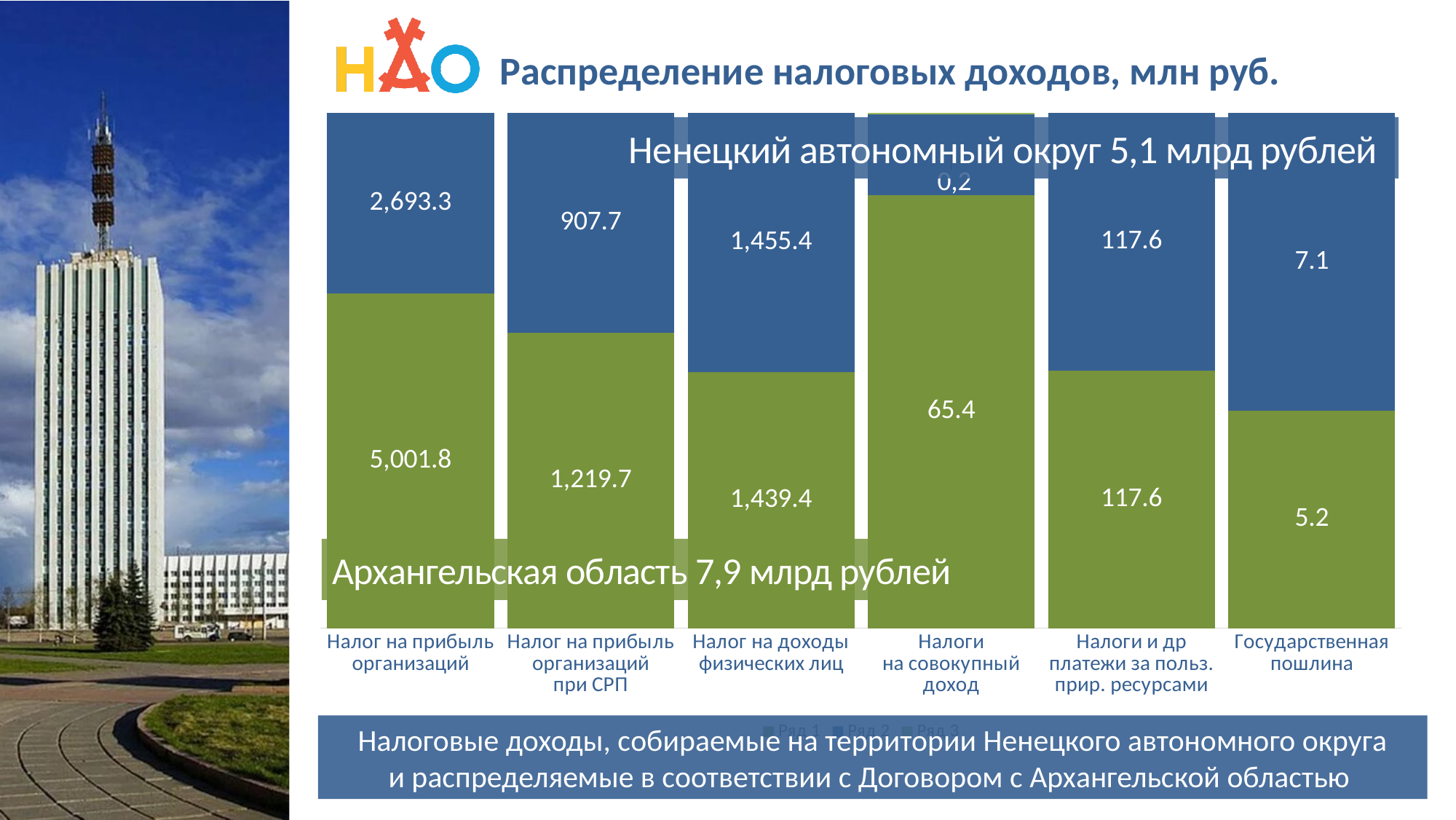
What is the value of the blue (upper) segment for Налог на прибыль организаций? 2,693.3 Which category has the highest value in the green (lower) segment? Налог на прибыль организаций What is the value of the green (lower) segment for Государственная пошлина? 5.2 Which category has the lowest value in the green (lower) segment? Государственная пошлина What is the total of the two labelled segments for Налог на прибыль организаций при СРП? 2,127.4 How many tax categories are shown along the x axis? 6 What is the value of the blue (upper) segment for Налог на прибыль организаций при СРП? 907.7 What kind of chart is shown on the slide? stacked bar chart What is the value of the green (lower) segment for Налог на прибыль организаций? 5,001.8 What is the value of the green (lower) segment for Налоги на совокупный доход? 65.4 What is the title of the chart? Распределение налоговых доходов, млн руб. What is the difference between the green and blue segment values for Налог на прибыль организаций? 2,308.5